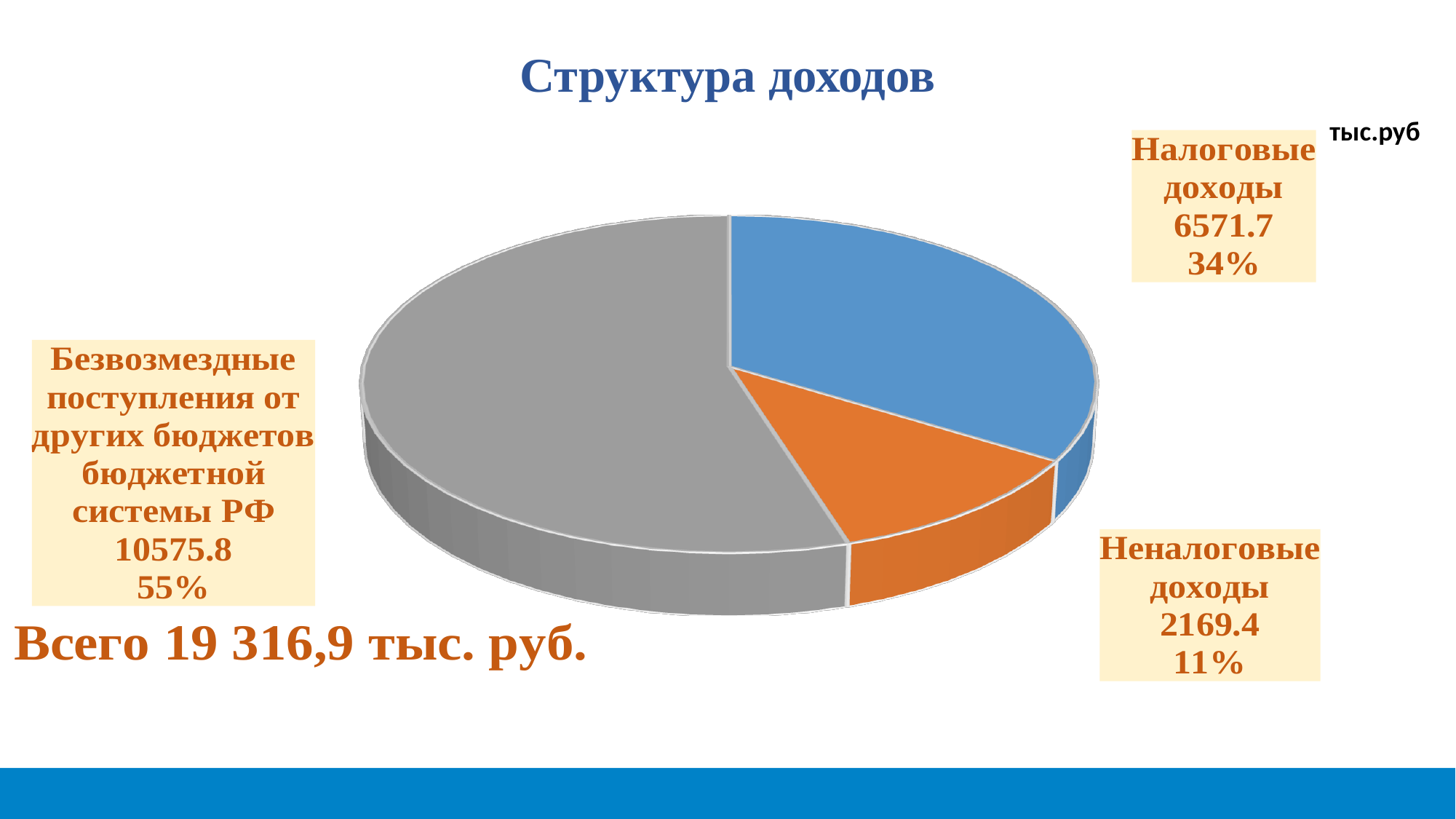
What is the value for Безвозмездные поступления от других бюджетов бюджетной системы РФ? 10575.8 Which is larger, Налоговые доходы or Неналоговые доходы? Налоговые доходы What share of the pie does Неналоговые доходы represent? 11% What is the value for Налоговые доходы? 6571.7 How many categories are shown in the pie chart? 3 What type of chart is shown on the slide? Pie chart What share of the pie does Безвозмездные поступления от других бюджетов бюджетной системы РФ represent? 55% Which category has the smallest slice of the pie? Неналоговые доходы What share of the pie does Налоговые доходы represent? 34% What is the difference between the values for Налоговые доходы and Неналоговые доходы? 4402.3 Which category has the largest slice of the pie? Безвозмездные поступления от других бюджетов бюджетной системы РФ What is the value for Неналоговые доходы? 2169.4